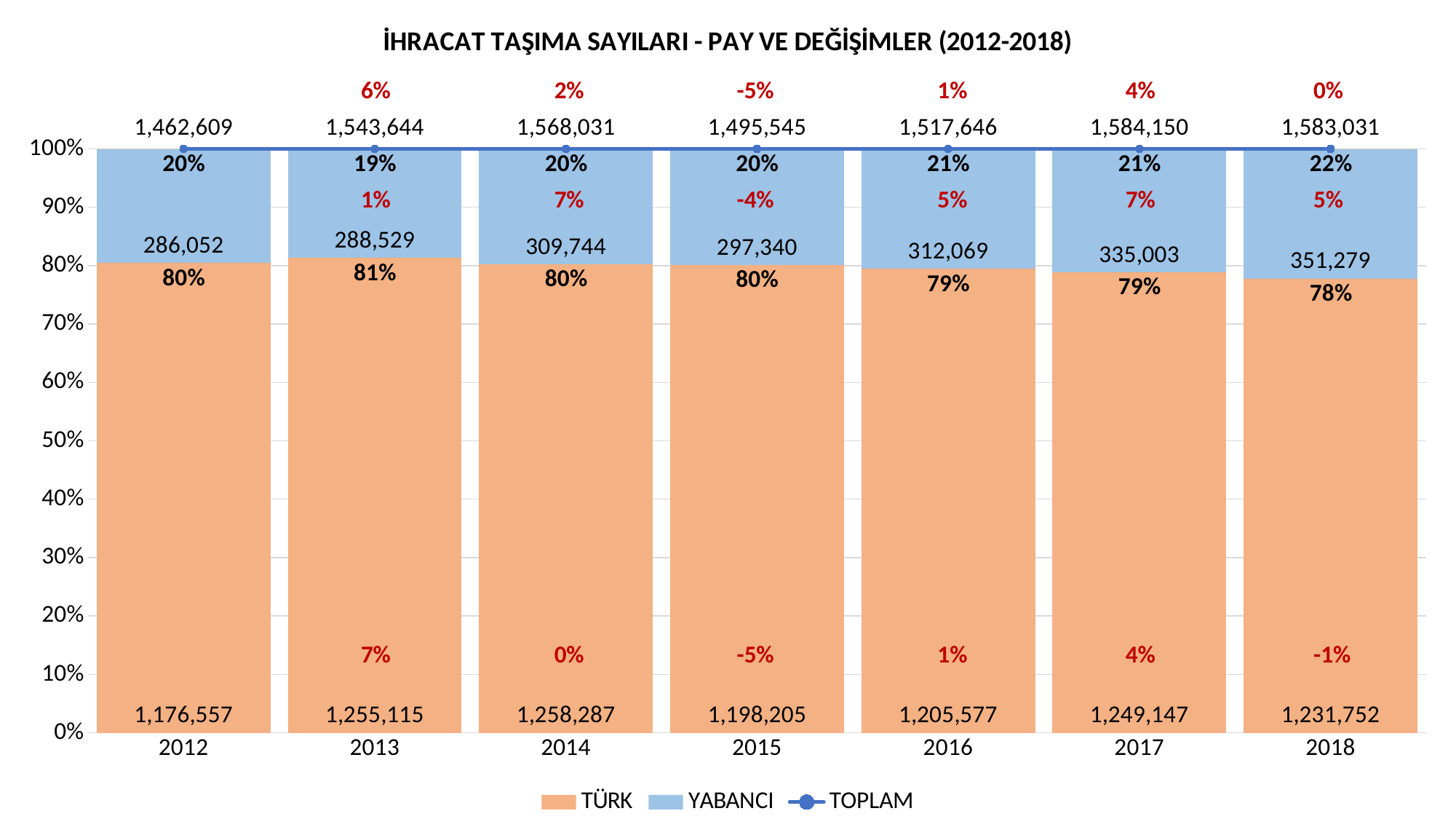
What kind of chart is this? Stacked bar chart with a line In which year is the YABANCI value lowest? 2012 Does the YABANCI value rise or fall from 2015 to 2018? Rise What is the TOPLAM value for 2015? 1,495,545 Which year has the larger TÜRK value, 2015 or 2016? 2016 What is the TÜRK value for 2014? 1,258,287 What is the YABANCI value for 2018? 351,279 What is the difference between the TOPLAM values for 2013 and 2012? 81,035 What percentage share does TÜRK have in 2013? 81% In which year is the TOPLAM value highest? 2017 How many years are shown on the x axis? 7 How many series does the legend list? 3